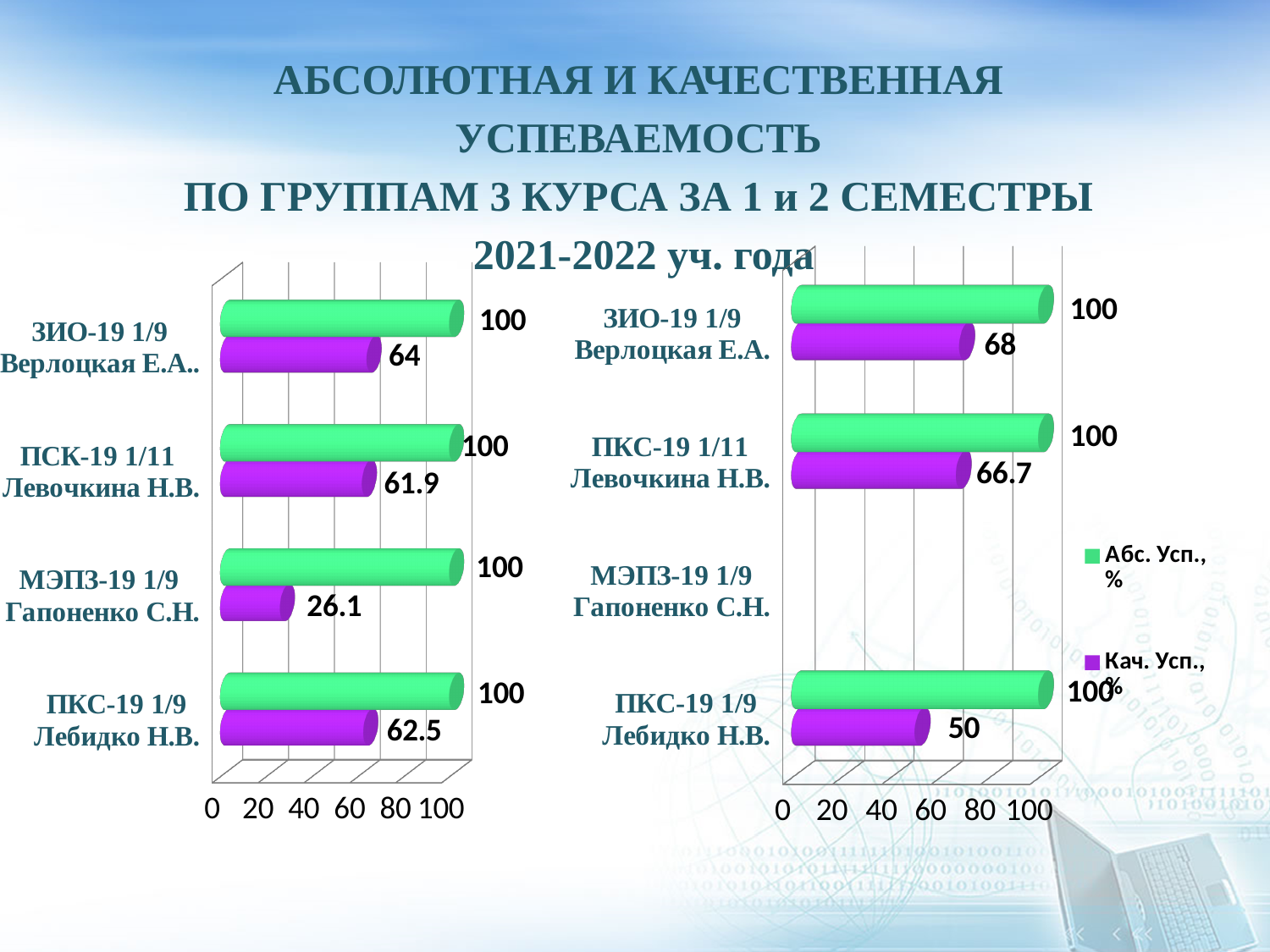
How many groups are listed on the category axis of the left chart? 4 What type of chart is the left chart? bar chart How many series does the legend on the right chart list? 2 In the left chart, what is the Кач. Усп., % value for МЭПЗ-19 1/9 Гапоненко С.Н.? 26.1 In the right chart, what is the difference between the Кач. Усп., % values for ЗИО-19 1/9 Верлоцкая Е.А. and ПКС-19 1/11 Левочкина Н.В.? 1.3 In the left chart, which group has the lowest Кач. Усп., % value? МЭПЗ-19 1/9 Гапоненко С.Н. In the left chart, what is the Кач. Усп., % value for ПСК-19 1/11 Левочкина Н.В.? 61.9 In the right chart, what is the Кач. Усп., % value for ПКС-19 1/9 Лебидко Н.В.? 50 In the left chart, what is the difference between the Абс. Усп., % and Кач. Усп., % values for ЗИО-19 1/9 Верлоцкая Е.А.? 36 In the right chart, which group has the lowest Кач. Усп., % value among those with bars shown? ПКС-19 1/9 Лебидко Н.В. Is the Кач. Усп., % value for ПКС-19 1/9 Лебидко Н.В. larger in the left chart or the right chart? left chart In the right chart, what is the Кач. Усп., % value for ЗИО-19 1/9 Верлоцкая Е.А.? 68